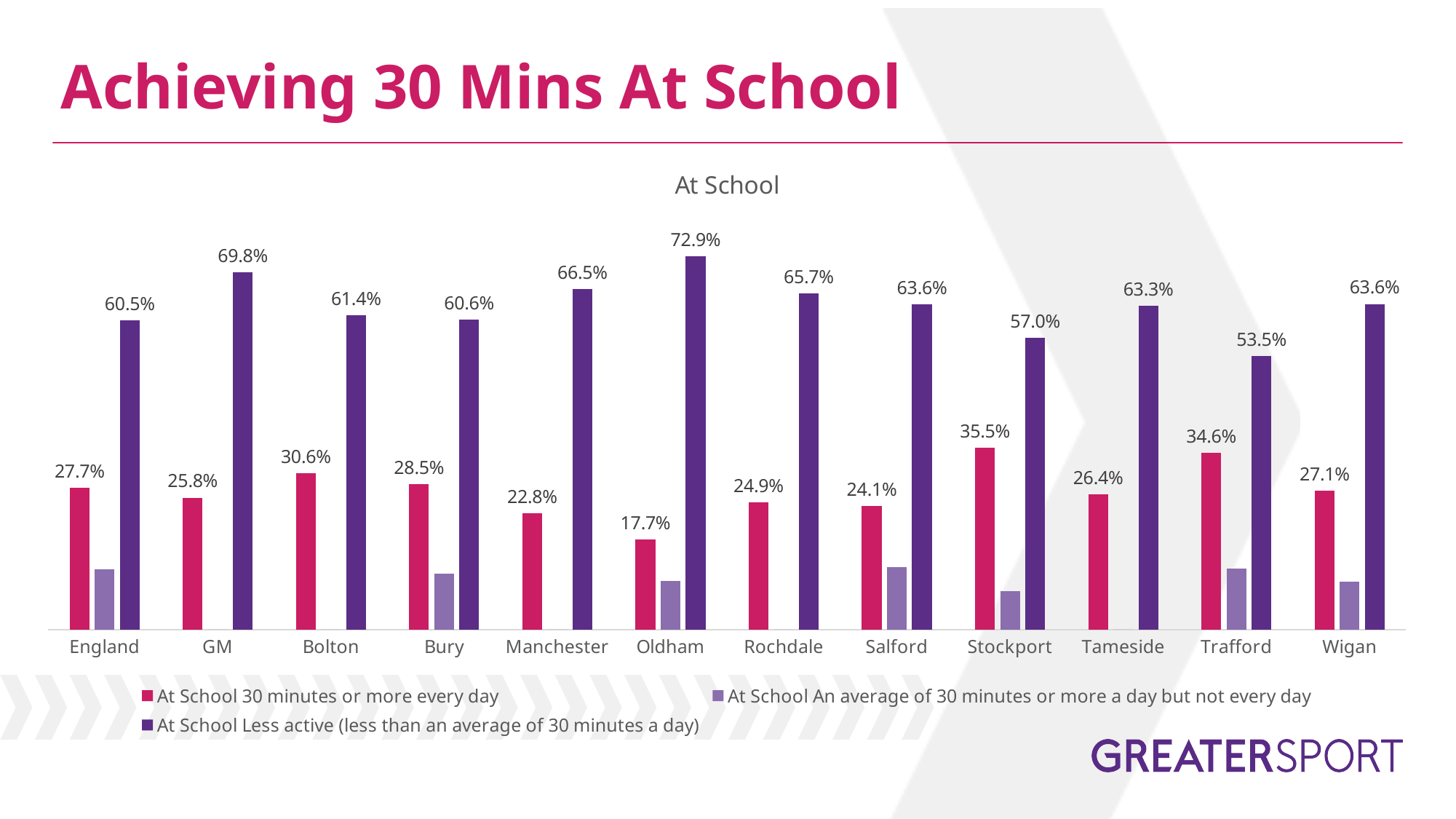
Which area has the lowest value in the 'At School Less active (less than an average of 30 minutes a day)' series? Trafford Which is larger in the 'At School 30 minutes or more every day' series: Trafford or Manchester? Trafford How many series does the legend list? 3 What is the difference between Bolton's and England's values in the 'At School Less active' series? 0.9 percentage points Which area has the lowest value in the 'At School 30 minutes or more every day' series? Oldham What is the value for Stockport in the 'At School 30 minutes or more every day' series? 35.5% How many areas are shown on the x axis? 12 What is the value for Oldham in the 'At School Less active (less than an average of 30 minutes a day)' series? 72.9% What is the value for GM in the 'At School Less active (less than an average of 30 minutes a day)' series? 69.8% Which area has the highest value in the 'At School Less active (less than an average of 30 minutes a day)' series? Oldham What is the difference between Oldham's 'Less active' value and its '30 minutes or more every day' value? 55.2 percentage points What kind of chart is shown on the slide? Bar chart